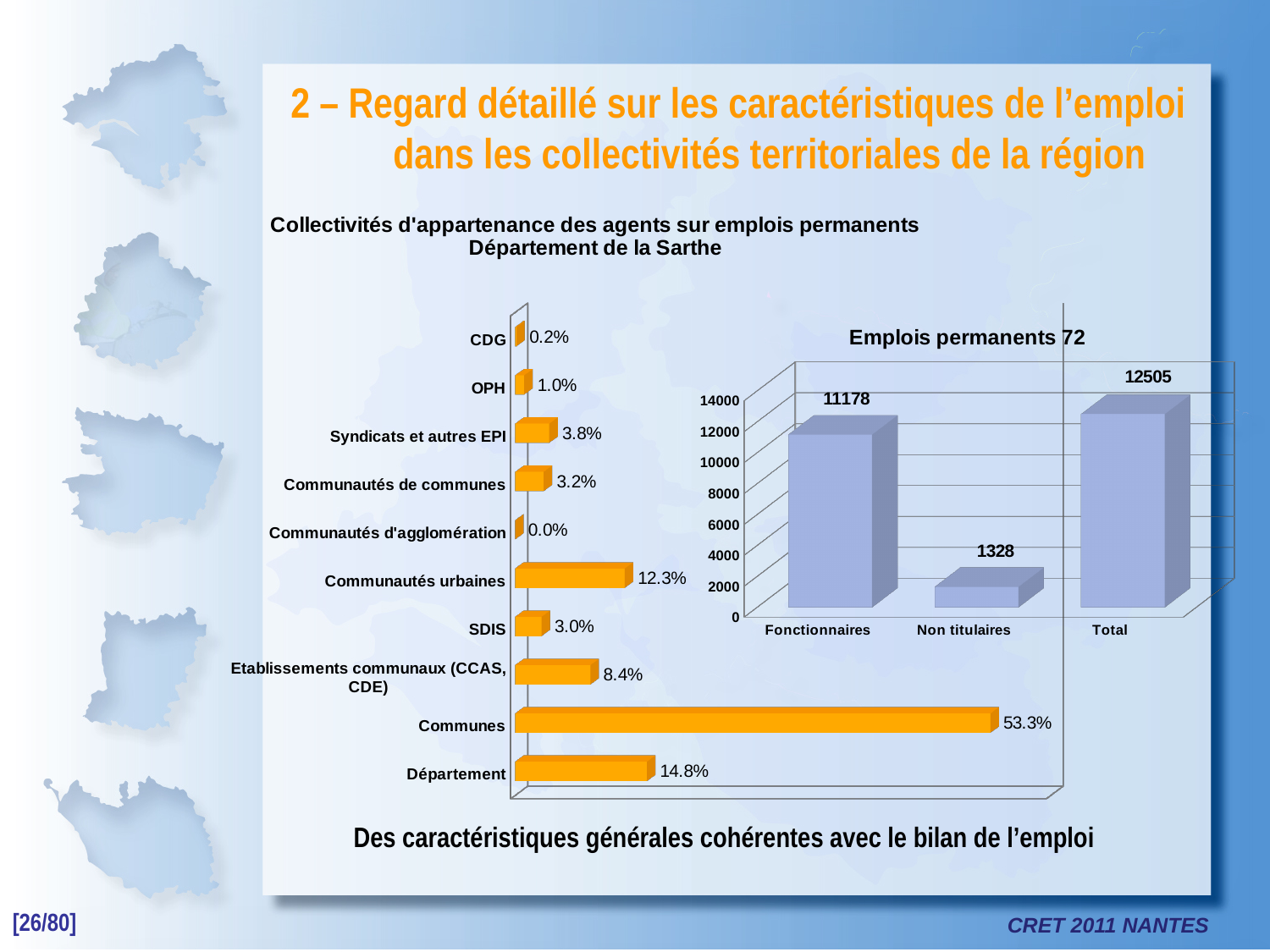
How many categories are shown in the chart 'Collectivités d'appartenance des agents sur emplois permanents'? 10 What kind of chart is 'Collectivités d'appartenance des agents sur emplois permanents'? Bar chart In the chart 'Collectivités d'appartenance des agents sur emplois permanents', what is the value for Communes? 53.3% In the chart 'Emplois permanents 72', what is the value for Non titulaires? 1328 In the chart 'Collectivités d'appartenance des agents sur emplois permanents', what is the difference between the values for Département and Etablissements communaux (CCAS, CDE)? 6.4% In the chart 'Collectivités d'appartenance des agents sur emplois permanents', what is the value for Communautés urbaines? 12.3% How many categories are shown in the chart 'Emplois permanents 72'? 3 In the chart 'Emplois permanents 72', what is the difference between Fonctionnaires and Non titulaires? 9850 In the chart 'Collectivités d'appartenance des agents sur emplois permanents', which category has the highest value? Communes In the chart 'Emplois permanents 72', what is the value for Fonctionnaires? 11178 In the chart 'Collectivités d'appartenance des agents sur emplois permanents', which is larger: Syndicats et autres EPI or SDIS? Syndicats et autres EPI In the chart 'Collectivités d'appartenance des agents sur emplois permanents', which category has the lowest value? Communautés d'agglomération